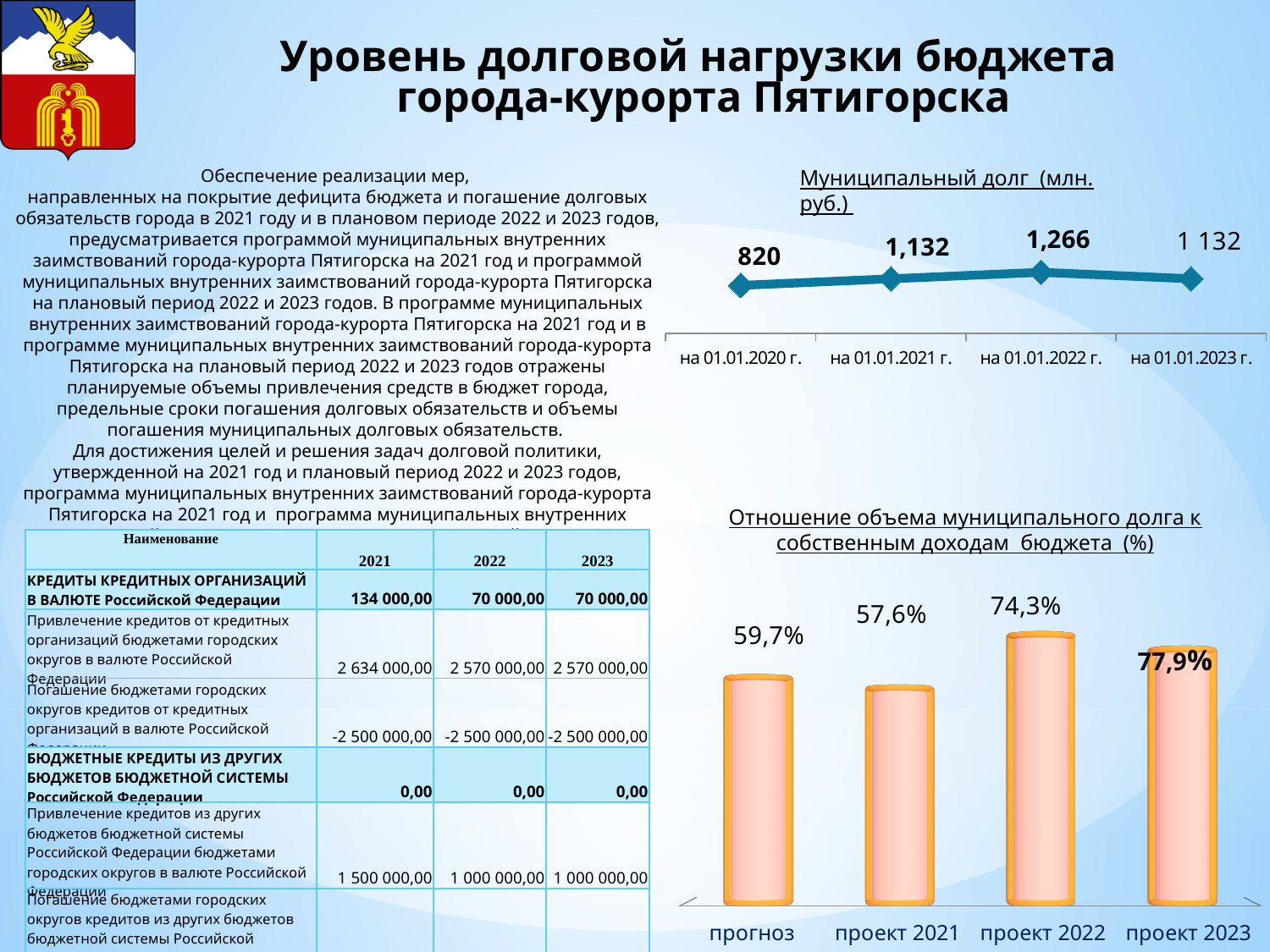
In the chart 'Отношение объема муниципального долга к собственным доходам бюджета (%)', which category has the lowest value? проект 2021 In the chart 'Отношение объема муниципального долга к собственным доходам бюджета (%)', what is the value for 'проект 2021'? 57,6% In the chart 'Муниципальный долг (млн. руб.)', which date has the highest value? на 01.01.2022 г. In the chart 'Муниципальный долг (млн. руб.)', what is the value on 01.01.2020? 820 In the chart 'Муниципальный долг (млн. руб.)', which date has the lowest value? на 01.01.2020 г. In the chart 'Муниципальный долг (млн. руб.)', what is the value on 01.01.2022? 1,266 In the chart 'Муниципальный долг (млн. руб.)', how many data points are plotted? 4 In the chart 'Отношение объема муниципального долга к собственным доходам бюджета (%)', what is the value for 'проект 2023'? 77,9% In the chart 'Отношение объема муниципального долга к собственным доходам бюджета (%)', which is larger: 'прогноз' or 'проект 2022'? проект 2022 What kind of chart is 'Муниципальный долг (млн. руб.)'? line chart What kind of chart is 'Отношение объема муниципального долга к собственным доходам бюджета (%)'? bar chart